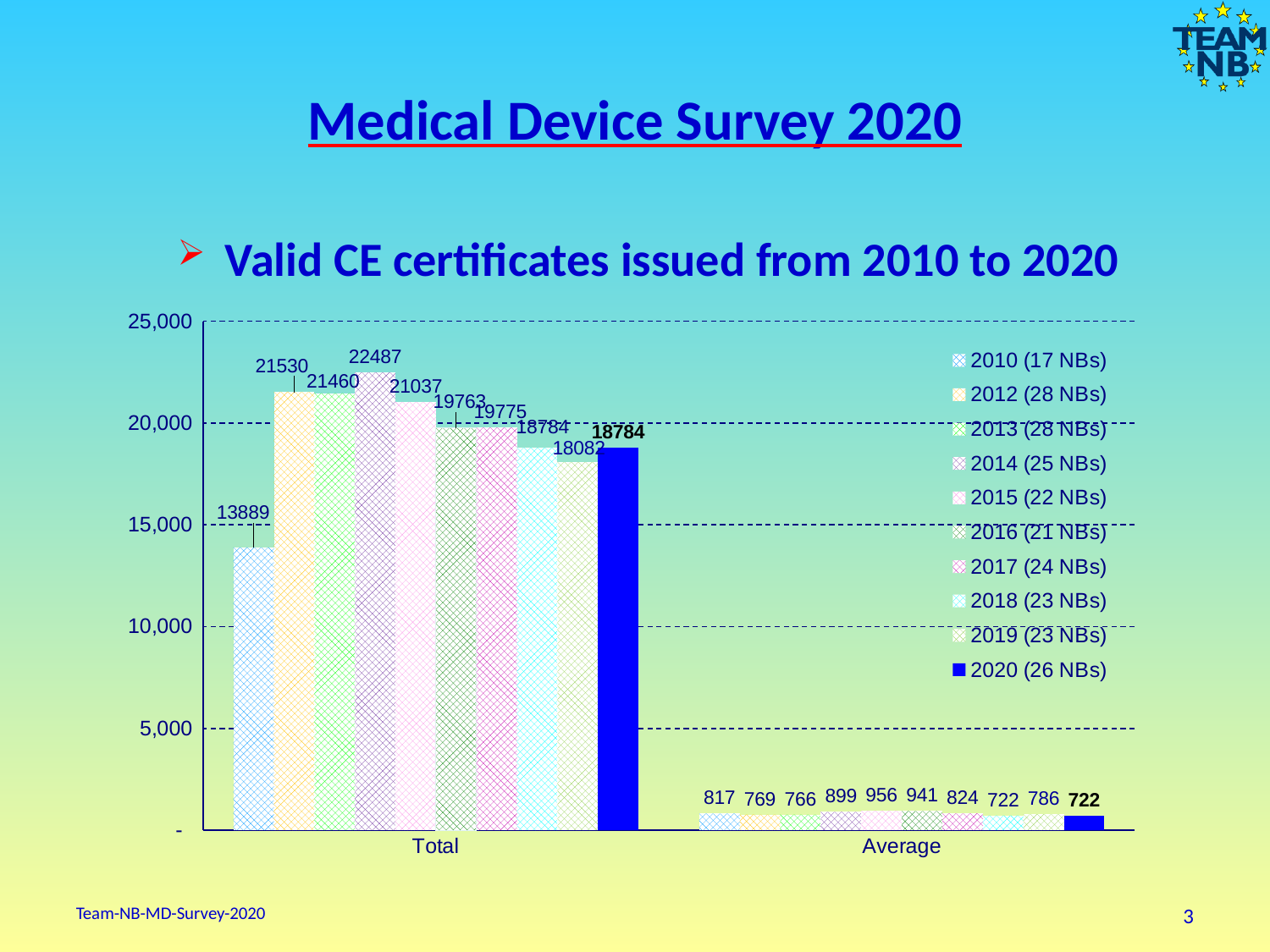
Which series has the highest Total value? 2014 (25 NBs) Which series has the highest Average value? 2015 (22 NBs) Which series has the lowest Total value? 2010 (17 NBs) How many series does the legend list? 10 What is the Total value for 2020 (26 NBs)? 18784 What is the Total value for 2010 (17 NBs)? 13889 Is the Total value for 2010 (17 NBs) greater or less than 15,000? less What kind of chart is shown on the slide? bar chart What is the difference between the Total values for 2014 (25 NBs) and 2010 (17 NBs)? 8598 How many categories are shown on the x axis? 2 Which is larger, the Total value for 2012 (28 NBs) or for 2013 (28 NBs)? 2012 (28 NBs) What is the Average value for 2015 (22 NBs)? 956